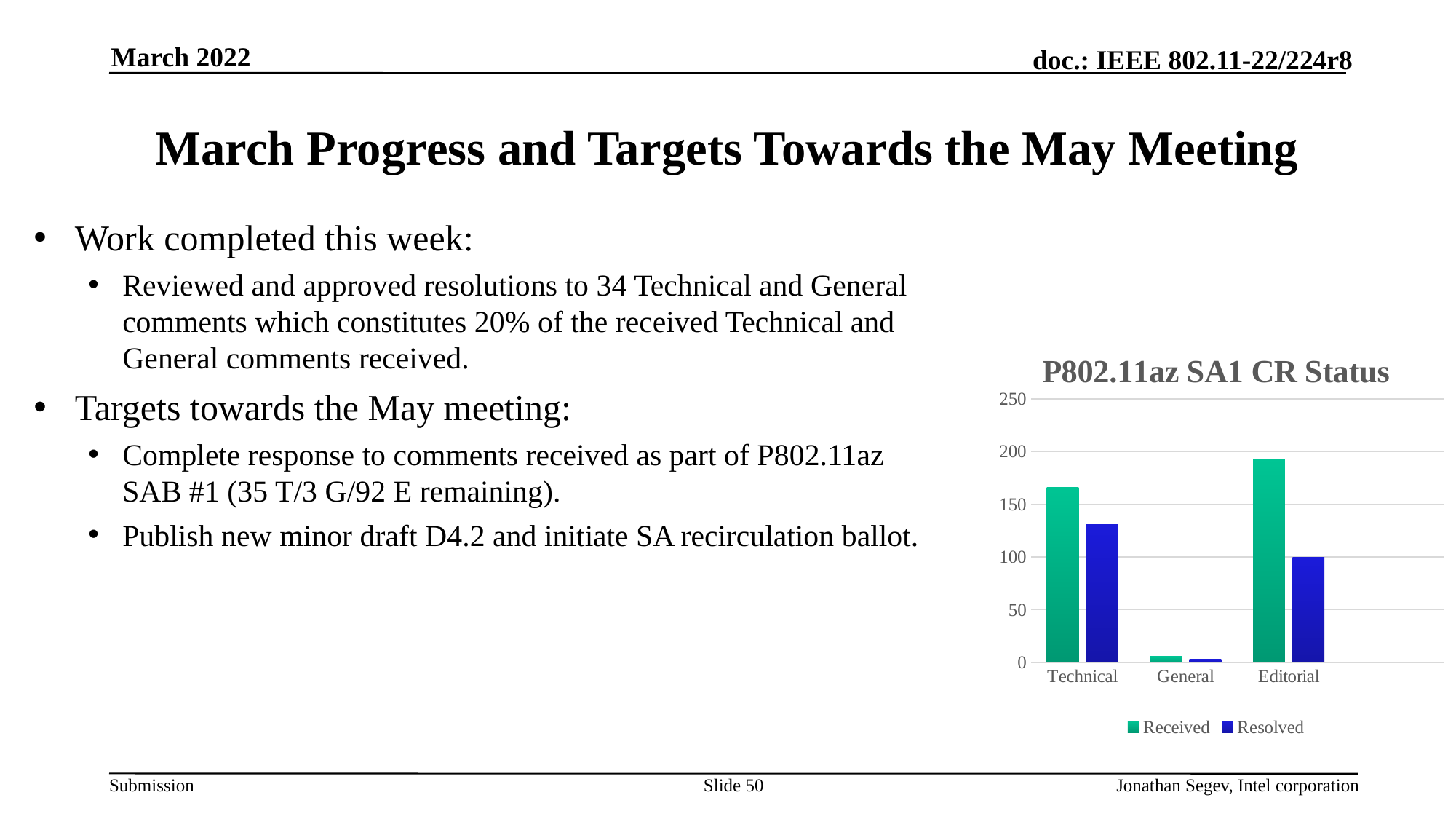
Is the Received value for Technical greater or less than 150? greater Which is larger, the Received value for Technical or the Received value for Editorial? Editorial What is the title of the chart? P802.11az SA1 CR Status How many series does the chart legend list? 2 How many categories are shown on the x axis of the chart? 3 Is the Received value for General greater or less than 50? less Which category has the highest Resolved value? Technical What type of chart is shown on the slide? bar chart Which category has the lowest Received value? General Which category has the highest Received value? Editorial Which series is shown in green in the chart? Received Is the Resolved value for Technical greater or less than 150? less